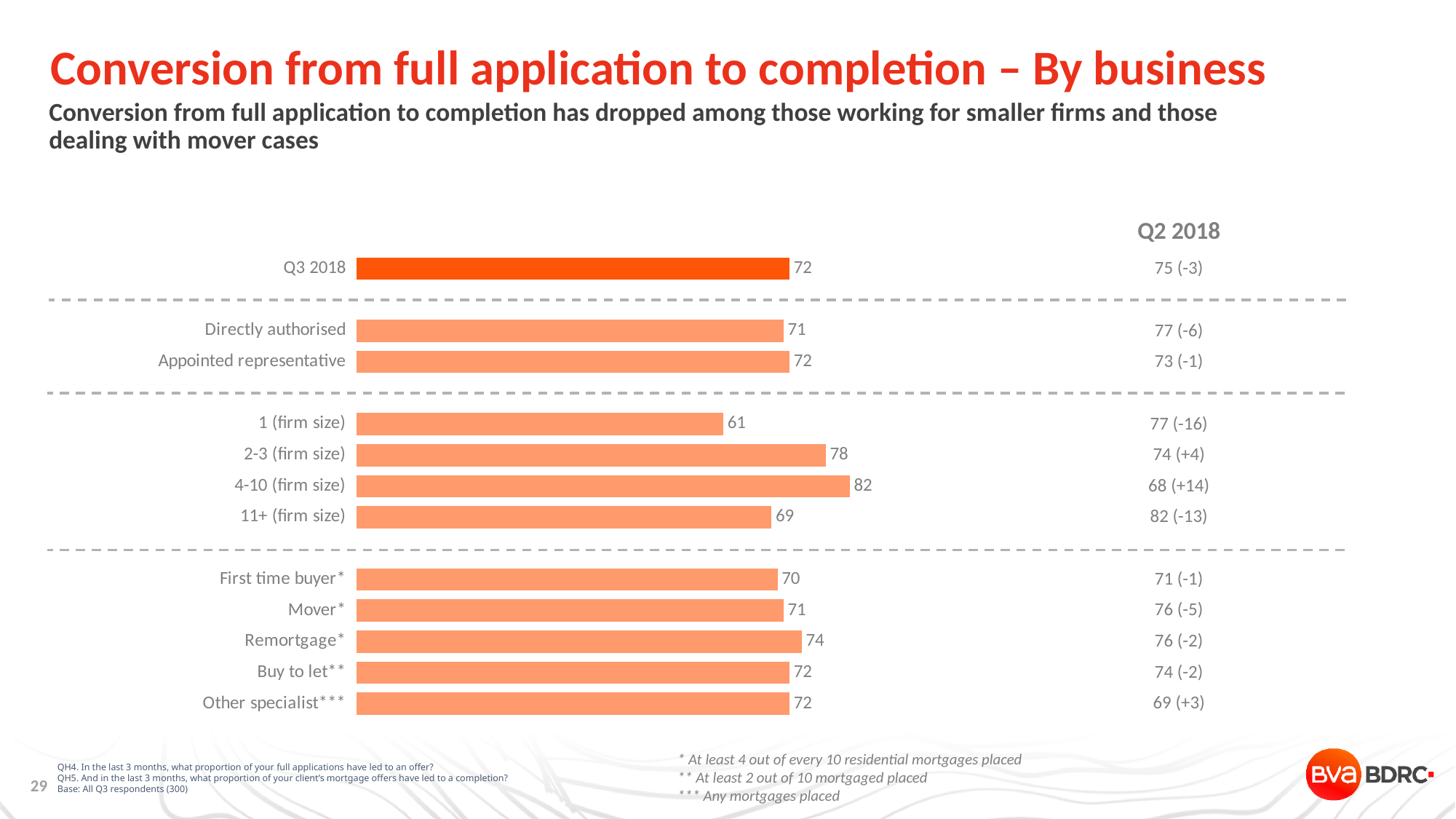
Which category has the lowest value? 1 (firm size) What Q2 2018 value is shown for 11+ (firm size)? 82 (-13) Which is larger, the value for Remortgage or the value for First time buyer? Remortgage How many bars are plotted in the chart? 12 What is the difference between the values for 4-10 (firm size) and 1 (firm size)? 21 What is the value for Remortgage? 74 What is the difference between the values for 2-3 (firm size) and 11+ (firm size)? 9 What is the value for 1 (firm size)? 61 Which category has the highest value? 4-10 (firm size) What kind of chart is shown on the slide? Bar chart What is the value for the Q3 2018 bar at the top of the chart? 72 What is the value for 4-10 (firm size)? 82